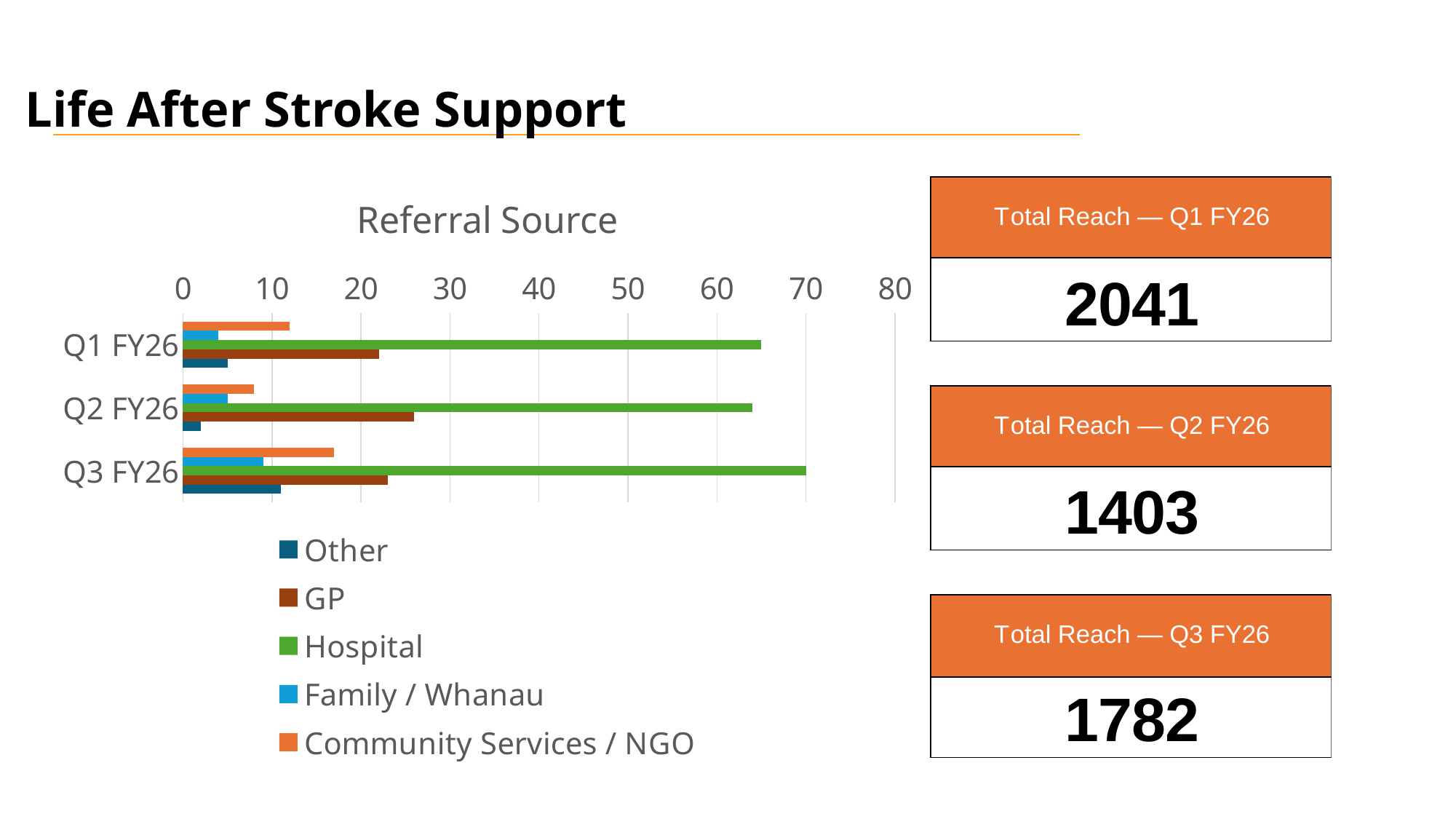
In the Referral Source chart, is the Community Services / NGO value for Q3 FY26 greater or less than 10? greater In the Referral Source chart, which series has the highest value for Q1 FY26? Hospital In the Referral Source chart, is the Other value for Q2 FY26 greater or less than 10? less How many quarters are shown on the Referral Source chart? 3 In the Referral Source chart, which quarter has the highest Hospital value? Q3 FY26 What is the title of the chart on the slide? Referral Source In the Referral Source chart, which series has the lowest value for Q2 FY26? Other In the Referral Source chart, is the GP value for Q2 FY26 greater or less than 20? greater How many series does the legend of the Referral Source chart list? 5 In the Referral Source chart, which is larger: the Other value for Q3 FY26 or the Other value for Q2 FY26? Q3 FY26 What kind of chart is the Referral Source chart? bar chart